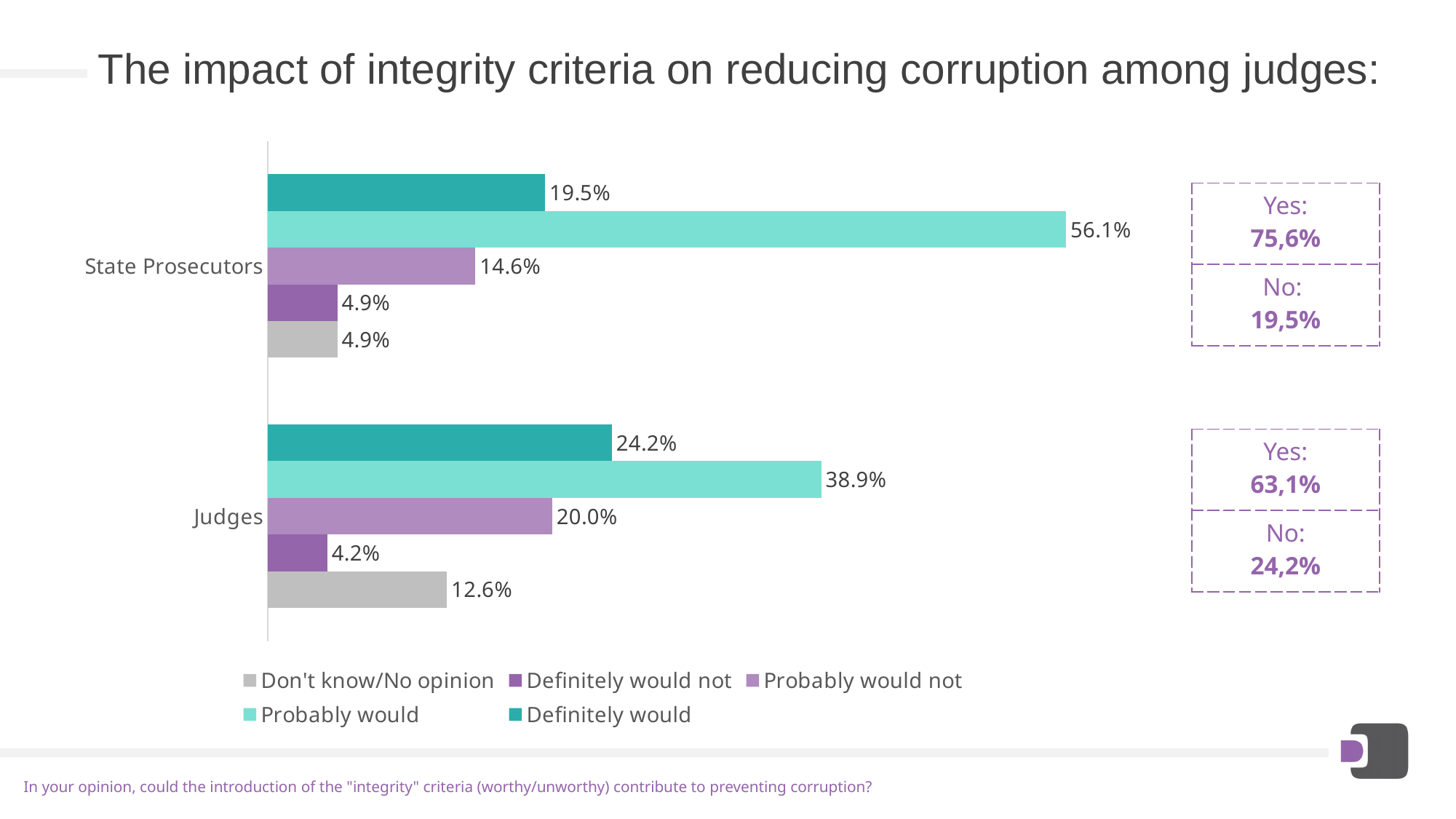
How many series does the legend list? 5 Which response category has the lowest value for Judges? Definitely would not Which group has a higher 'Definitely would' value, State Prosecutors or Judges? Judges What percentage of Judges answered 'Definitely would'? 24.2% What is the combined 'Yes' percentage shown for State Prosecutors in the box on the right? 75,6% Which response category has the highest value for Judges? Probably would How many groups (categories) are shown on the chart? 2 What percentage of Judges answered 'Don't know/No opinion'? 12.6% What is the difference between the 'Probably would' values for State Prosecutors and Judges? 17.2% What type of chart is shown on the slide? Bar chart What percentage of State Prosecutors answered 'Definitely would not'? 4.9% What percentage of State Prosecutors answered 'Probably would'? 56.1%